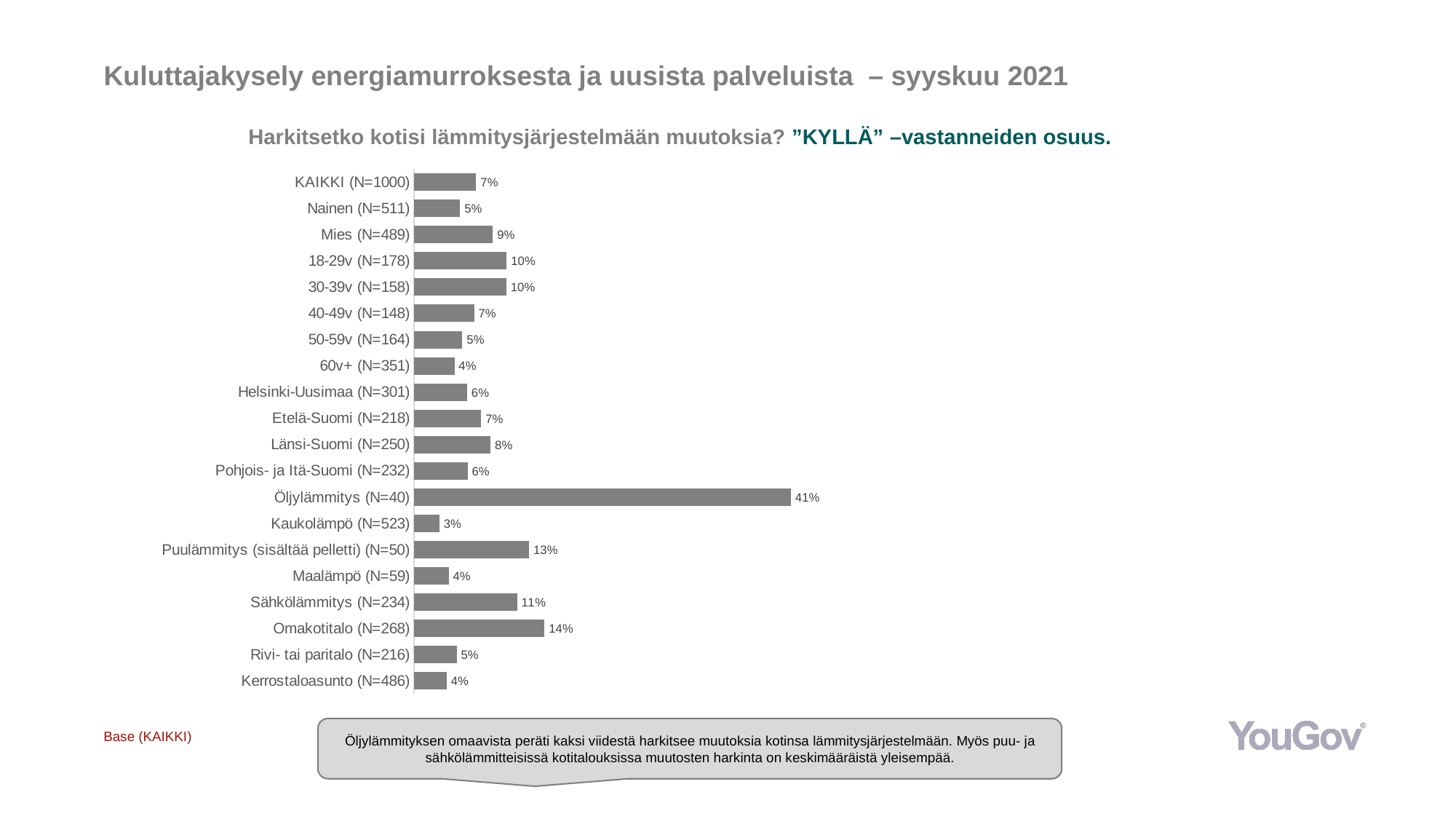
How many categories are shown in the chart? 20 What is the value for Kaukolämpö (N=523)? 3% What is the difference between the values for Mies (N=489) and Nainen (N=511)? 4% What colour are the bars in the chart? Grey Which category has the lowest value? Kaukolämpö (N=523) What kind of chart is shown on the slide? Bar chart Which is larger, the value for Sähkölämmitys (N=234) or the value for Maalämpö (N=59)? Sähkölämmitys (N=234) Which category has the highest value? Öljylämmitys (N=40) What is the value for Öljylämmitys (N=40)? 41% What is the value for KAIKKI (N=1000)? 7% What is the value for Omakotitalo (N=268)? 14% What is the difference between the values for Öljylämmitys (N=40) and Puulämmitys (sisältää pelletti) (N=50)? 28%